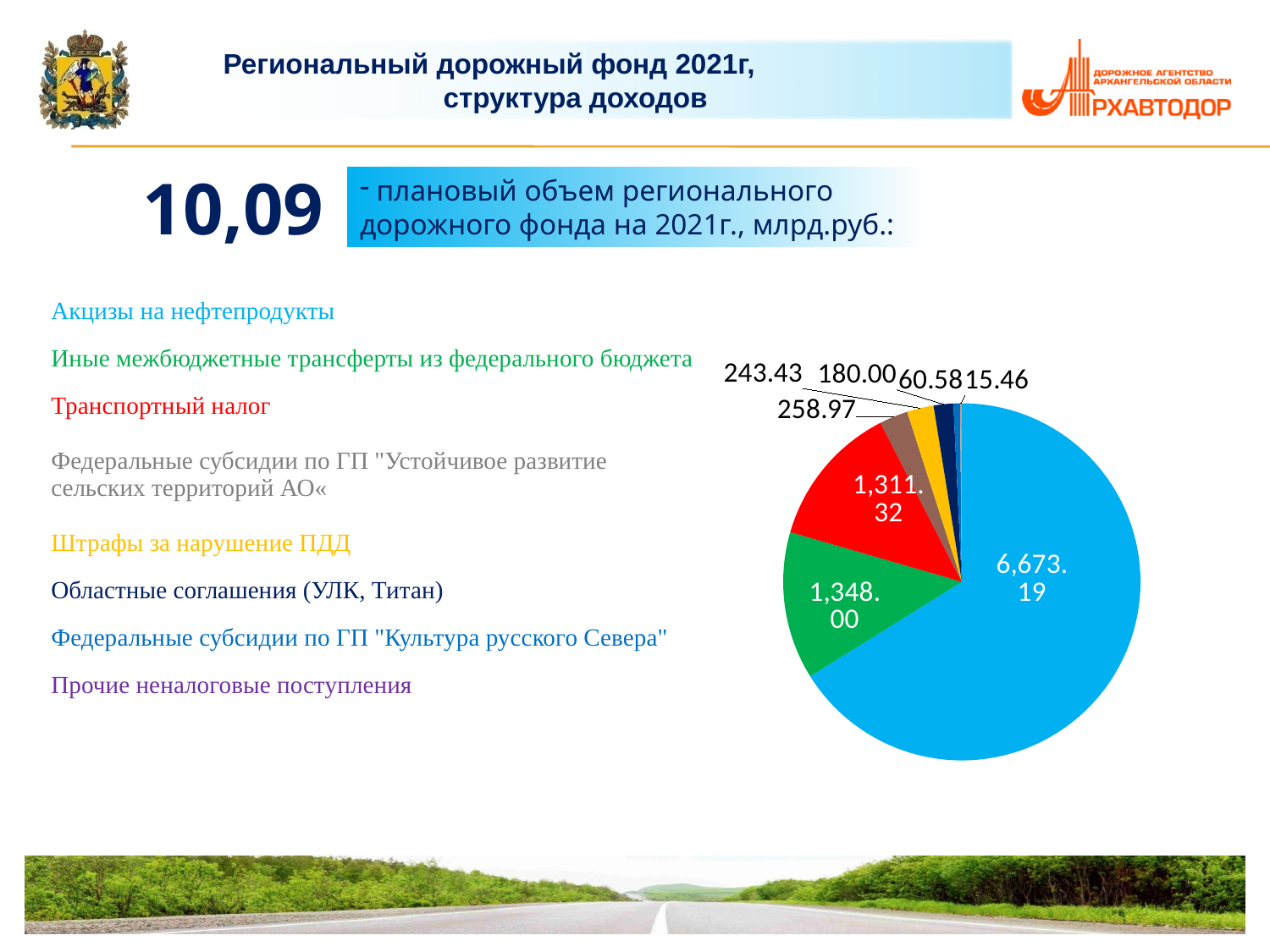
What is the value of the dark blue slice (Областные соглашения (УЛК, Титан))? 180.00 What is the difference between the green slice (1,348.00) and the red slice (1,311.32)? 36.68 Which is larger: the green slice (1,348.00) or the red slice (1,311.32)? the green slice (1,348.00) What is the value of the largest slice of the pie chart? 6,673.19 What kind of chart is shown on the slide? pie chart What is the value of the yellow slice (Штрафы за нарушение ПДД)? 243.43 What is the difference between the largest slice (6,673.19) and the green slice (1,348.00)? 5,325.19 What is the value of the green slice (Иные межбюджетные трансферты из федерального бюджета)? 1,348.00 Which category in the list corresponds to the largest (light blue) slice of the pie chart? Акцизы на нефтепродукты What is the value of the smallest slice of the pie chart? 15.46 What is the value of the red slice (Транспортный налог)? 1,311.32 How many slices does the pie chart have? 8